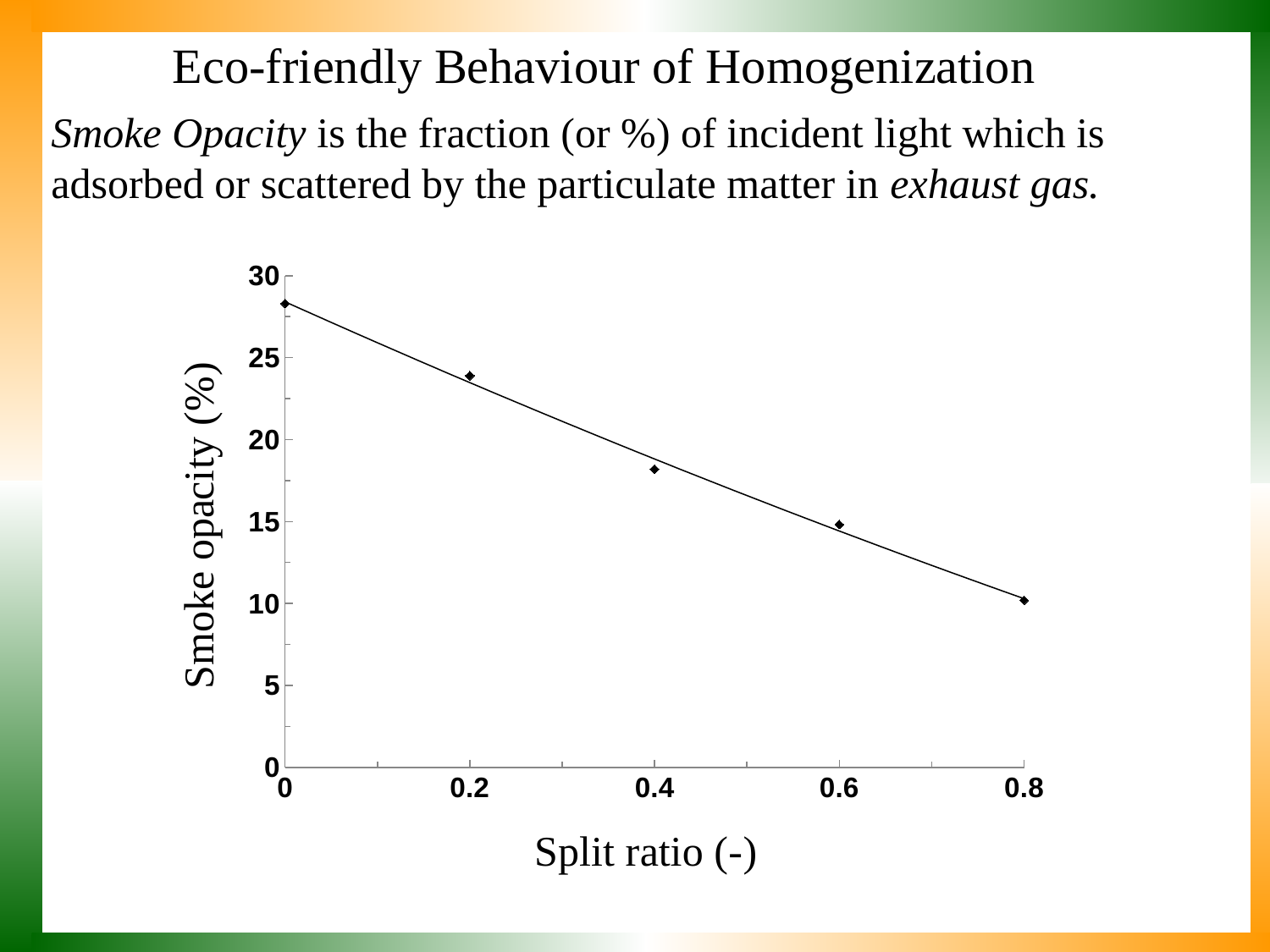
What is the label of the vertical axis? Smoke opacity (%) Which has the higher smoke opacity: split ratio 0.2 or split ratio 0.6? 0.2 At which split ratio is smoke opacity highest? 0 At which split ratio is smoke opacity lowest? 0.8 What is the label of the horizontal axis? Split ratio (-) Is the smoke opacity at split ratio 0.8 greater or less than 15? less Is the smoke opacity at split ratio 0 greater or less than 25? greater Is the smoke opacity at split ratio 0.4 greater or less than 20? less How many data points are plotted on the chart? 5 Does smoke opacity rise or fall as the split ratio increases? fall What kind of chart is shown on the slide? line chart